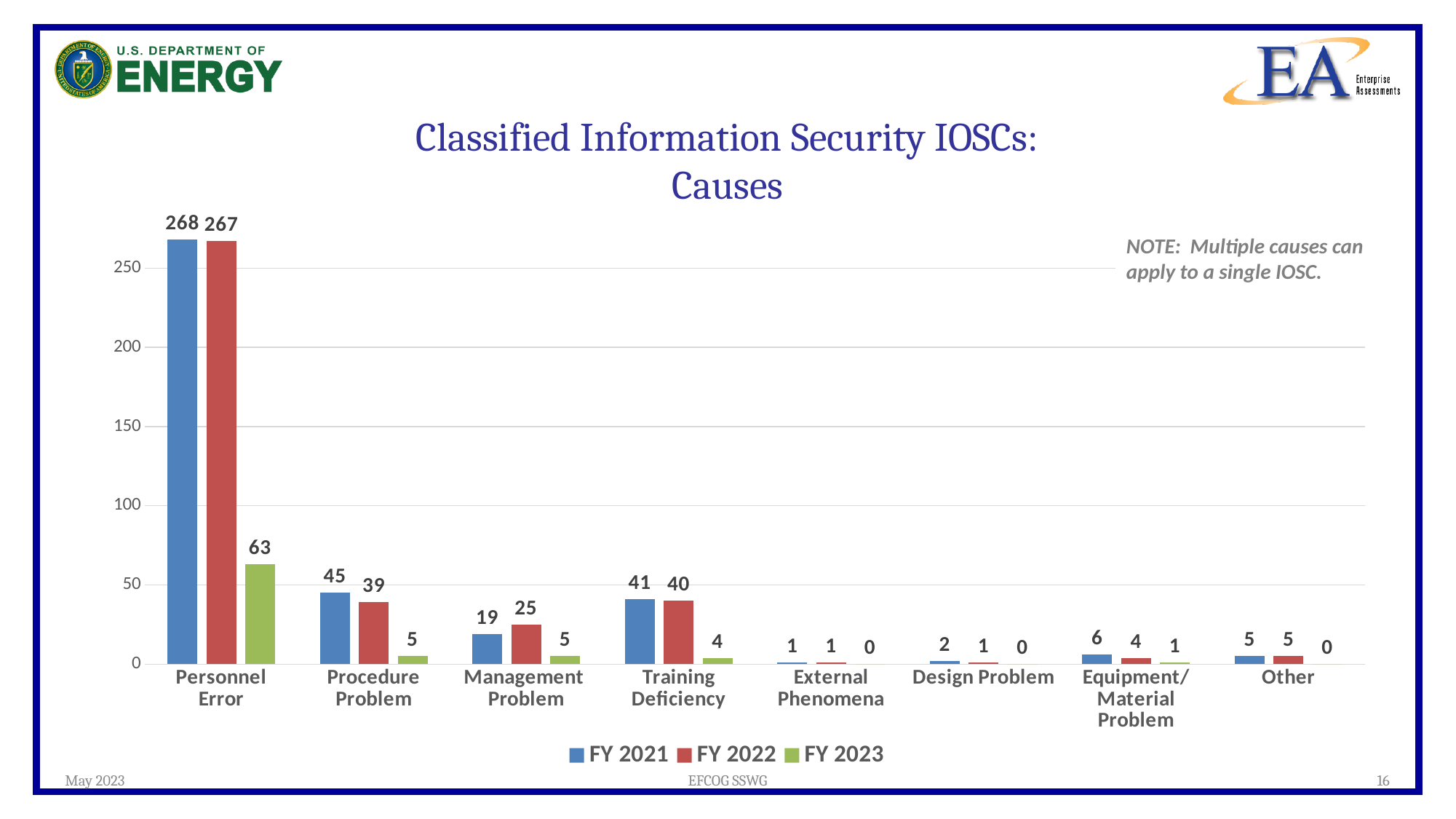
What is the FY 2021 value for Equipment/Material Problem? 6 What is the FY 2023 value for Personnel Error? 63 What is the FY 2021 value for Personnel Error? 268 How many series does the legend list? 3 Which category has the highest FY 2022 value? Personnel Error What is the difference between the FY 2021 and FY 2023 values for Personnel Error? 205 Which is larger for Management Problem, the FY 2021 value or the FY 2022 value? FY 2022 What is the difference between the FY 2021 and FY 2022 values for Procedure Problem? 6 What kind of chart is shown on the slide? Bar chart What is the FY 2022 value for Management Problem? 25 How many cause categories are shown on the x axis? 8 Which category has the lowest FY 2021 value? External Phenomena